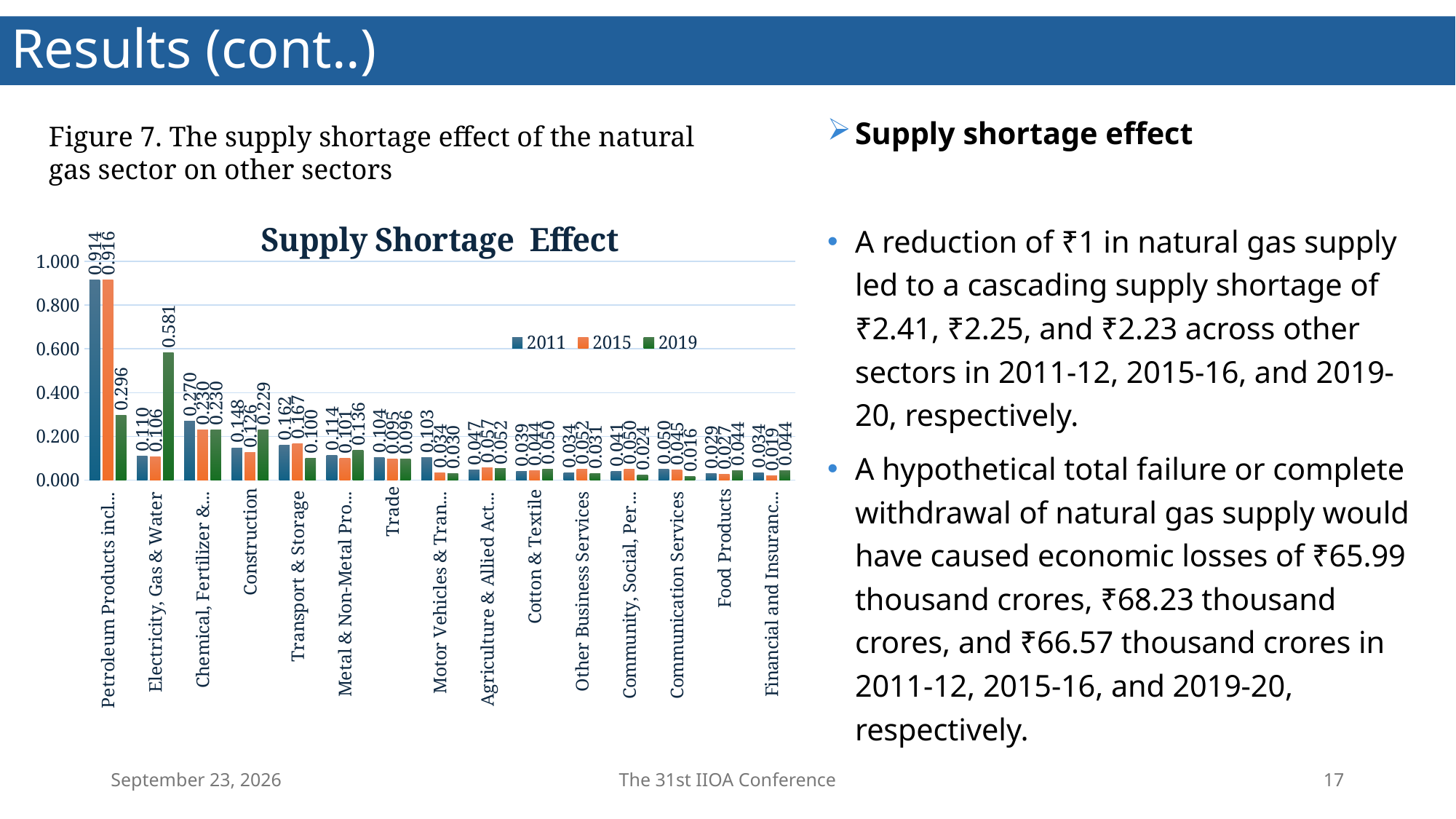
Which sector has the highest 2011 value in the Supply Shortage Effect chart? Petroleum Products incl... Which sector has the highest 2019 value in the Supply Shortage Effect chart? Electricity, Gas & Water How many sector categories are plotted along the x axis of the Supply Shortage Effect chart? 15 What is the 2019 value for Electricity, Gas & Water in the Supply Shortage Effect chart? 0.581 How many series does the legend of the Supply Shortage Effect chart list? 3 What is the 2019 value for Construction in the Supply Shortage Effect chart? 0.229 Is the 2011 value for Petroleum Products in the Supply Shortage Effect chart greater or less than 0.800? greater What is the title of the chart on the slide? Supply Shortage Effect What kind of chart is shown on the slide? bar chart What is the difference between the 2015 and 2019 values for Petroleum Products in the Supply Shortage Effect chart? 0.620 Do the 2011 values in the Supply Shortage Effect chart generally rise or fall from left to right along the x axis? fall In the Supply Shortage Effect chart, which is larger for 2019: Electricity, Gas & Water or Petroleum Products? Electricity, Gas & Water